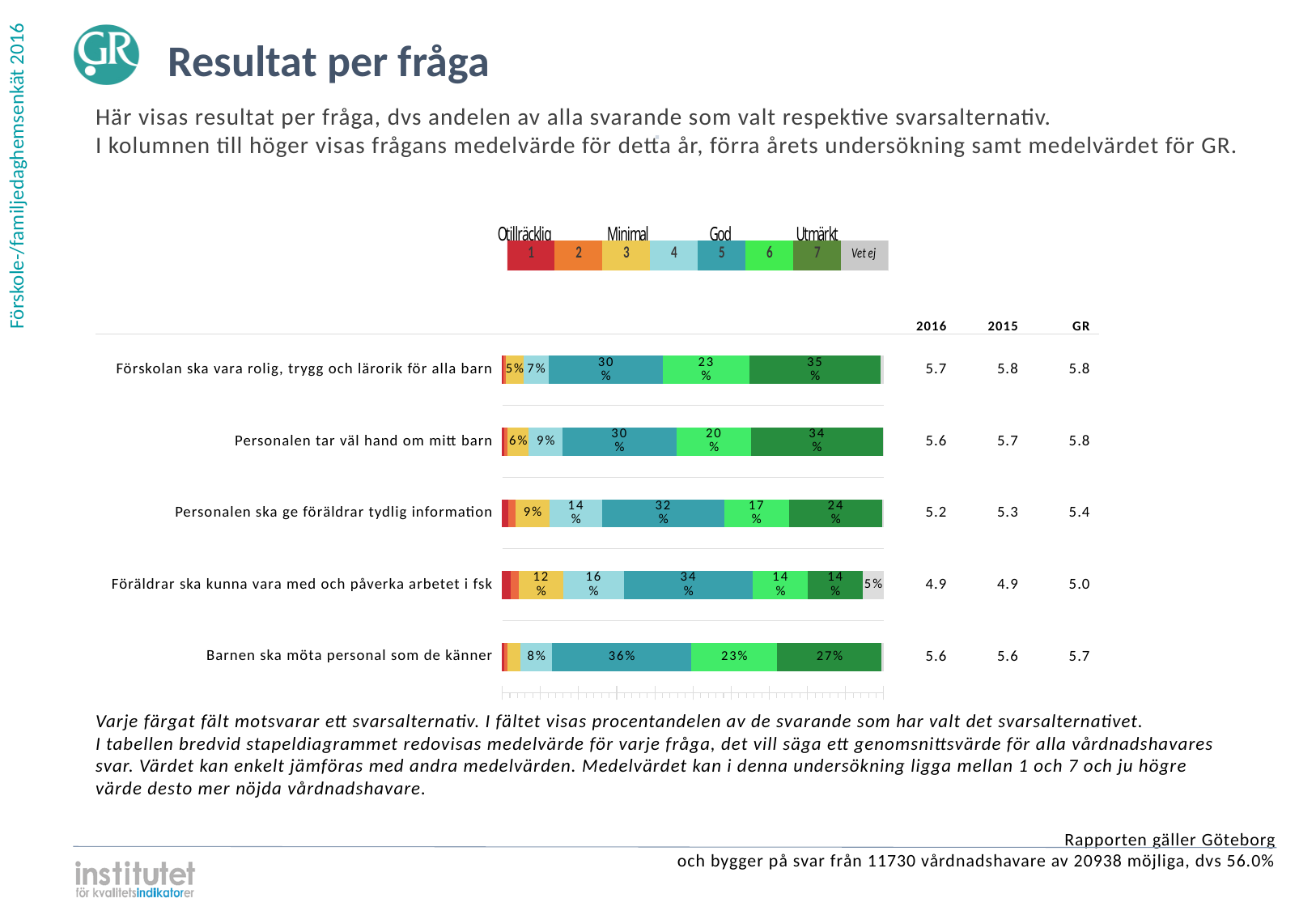
What kind of chart is shown on the slide? Stacked horizontal bar chart What is the "Vet ej" share for "Föräldrar ska kunna vara med och påverka arbetet i fsk"? 5% What label does the legend give to answer option 7? Utmärkt Which has a larger share of answer 6 (light green): "Förskolan ska vara rolig, trygg och lärorik för alla barn" or "Personalen tar väl hand om mitt barn"? Förskolan ska vara rolig, trygg och lärorik för alla barn How much larger is the answer 5 (teal) share for "Barnen ska möta personal som de känner" than for "Förskolan ska vara rolig, trygg och lärorik för alla barn"? 6 percentage points Which question has the largest share of answer 7 (dark green)? Förskolan ska vara rolig, trygg och lärorik för alla barn What percentage chose answer 5 (teal) for "Barnen ska möta personal som de känner"? 36% What is the 2016 mean value for "Personalen ska ge föräldrar tydlig information"? 5.2 Which question has the lowest 2016 mean value? Föräldrar ska kunna vara med och påverka arbetet i fsk What percentage chose answer 3 (yellow) for "Föräldrar ska kunna vara med och påverka arbetet i fsk"? 12% What percentage of respondents chose answer 7 (dark green) for "Förskolan ska vara rolig, trygg och lärorik för alla barn"? 35% How many questions (bars) are shown in the chart? 5